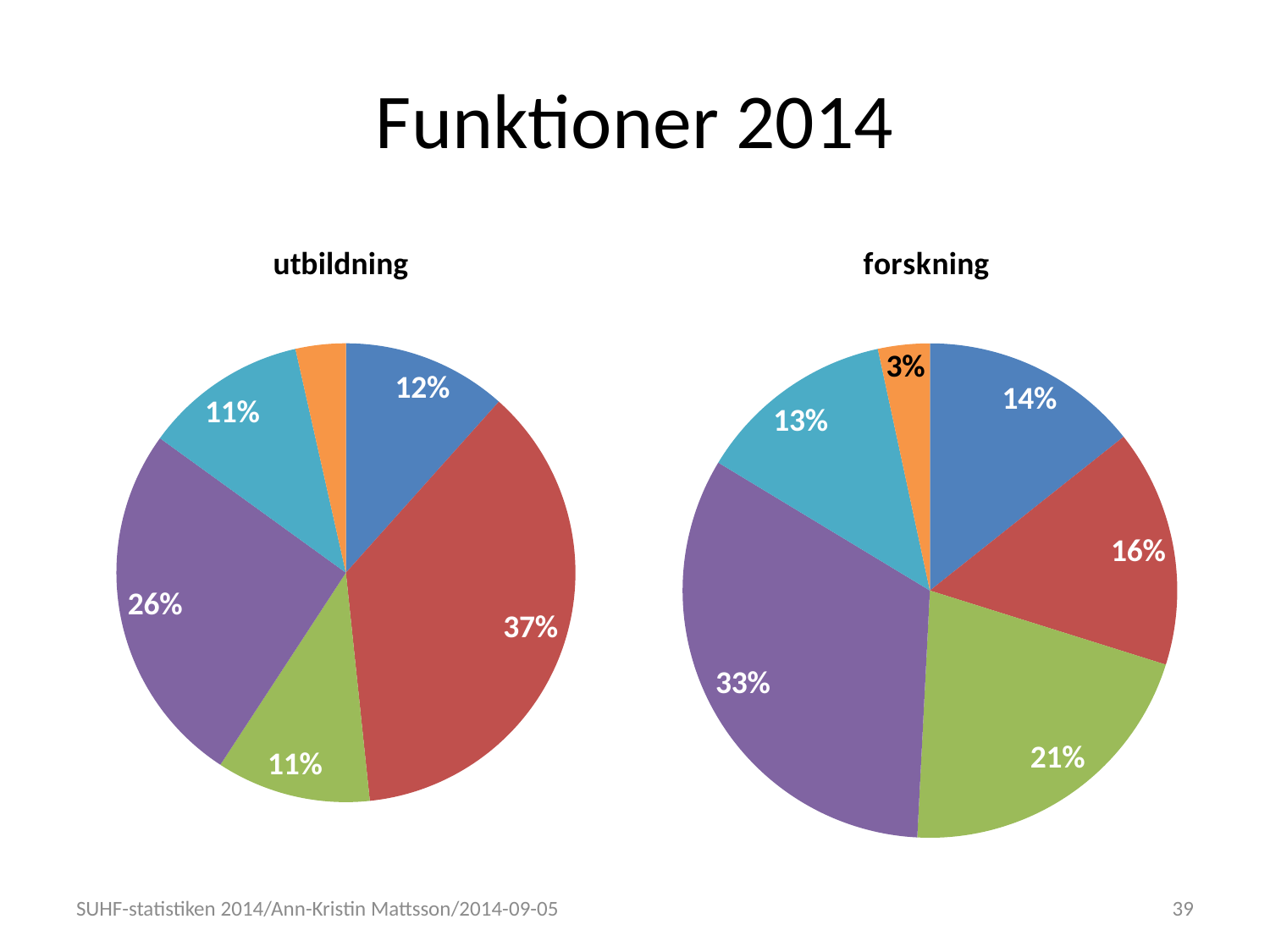
What are the titles of the two pie charts on the slide? utbildning and forskning In the "forskning" pie chart, which slice has the largest share? the purple slice (33%) In the "utbildning" pie chart, which slice has the largest share? the red slice (37%) What kind of chart is used for "utbildning" on the slide? pie chart In the "utbildning" pie chart, which is larger, the red slice or the purple slice? the red slice In the "forskning" pie chart, what percentage is shown on the green slice? 21% In the "forskning" pie chart, which slice has the smallest share? the orange slice (3%) In the "forskning" pie chart, what percentage is shown on the orange slice? 3% In the "utbildning" pie chart, what percentage is shown on the red slice? 37% How many slices does the "forskning" pie chart have? 6 In the "forskning" pie chart, how many percentage points larger is the purple slice than the green slice? 12 percentage points In the "utbildning" pie chart, what percentage is shown on the purple slice? 26%